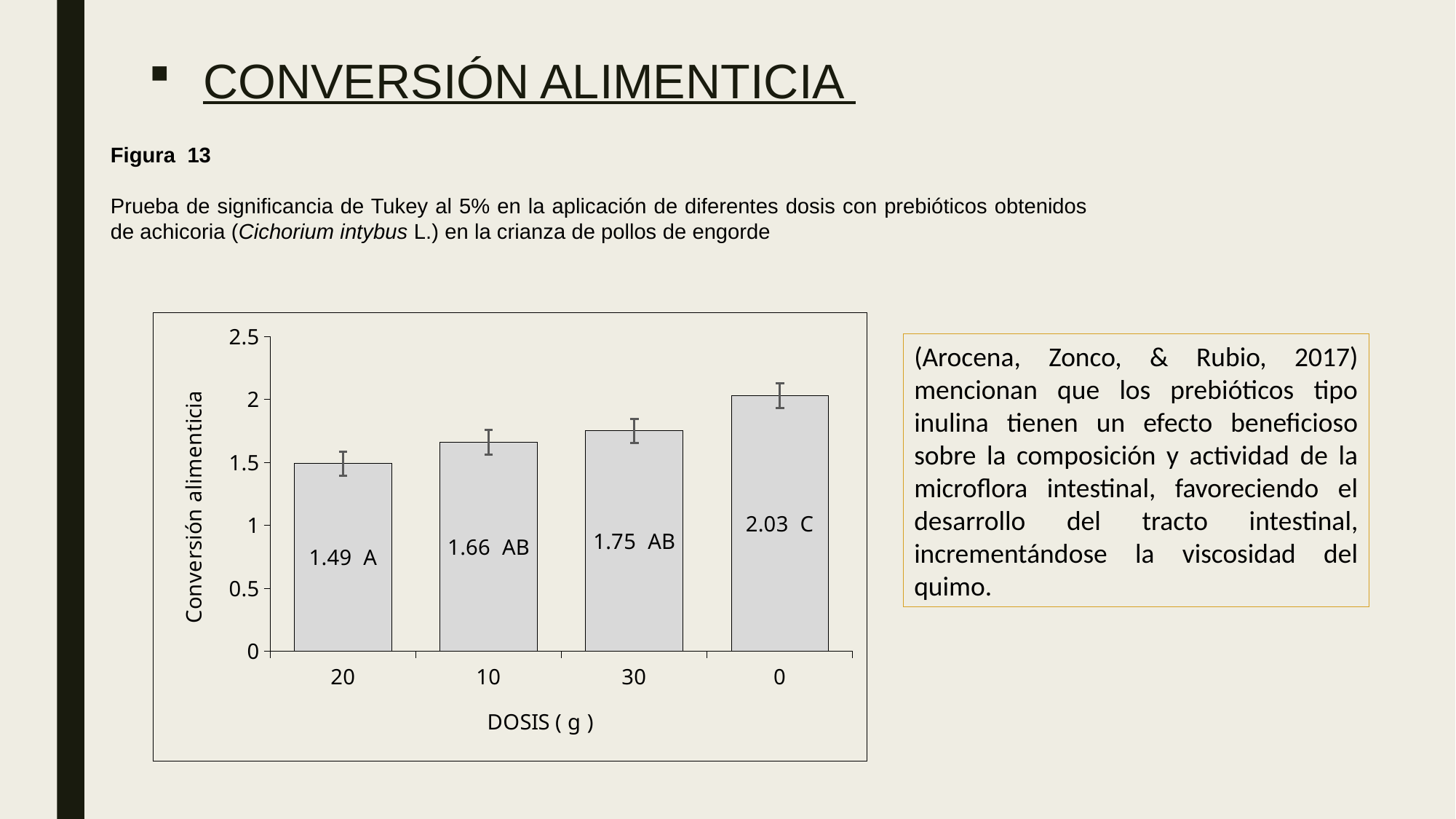
What is the conversión alimenticia value for the 0 g dose? 2.03 Which dose has the highest conversión alimenticia? 0 What is the conversión alimenticia value for the 10 g dose? 1.66 What is the conversión alimenticia value for the 20 g dose? 1.49 What is the label of the x axis of the chart? DOSIS ( g ) What is the conversión alimenticia value for the 30 g dose? 1.75 What is the difference in conversión alimenticia between the 0 g dose and the 20 g dose? 0.54 How many dose categories are shown on the x axis? 4 Is the conversión alimenticia for the 0 g dose greater or less than 2? greater Which dose has the lowest conversión alimenticia? 20 Which has a larger conversión alimenticia, the 10 g dose or the 30 g dose? 30 What kind of chart is shown on the slide? bar chart